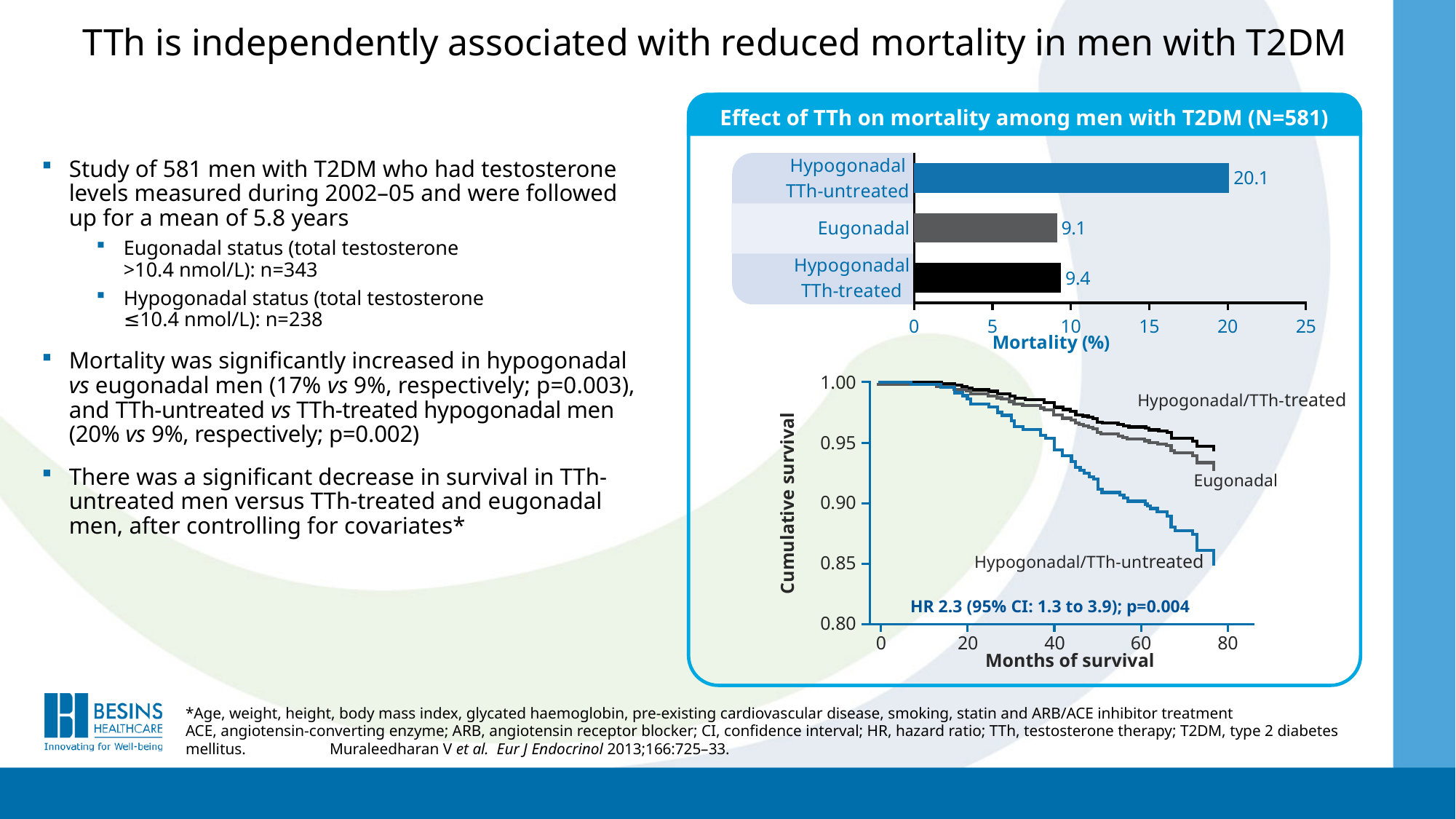
In the bar chart 'Effect of TTh on mortality among men with T2DM', what is the mortality (%) for the Hypogonadal TTh-untreated group? 20.1 In the bar chart 'Effect of TTh on mortality among men with T2DM', what is the difference in mortality (%) between the Hypogonadal TTh-untreated and Hypogonadal TTh-treated groups? 10.7 In the bar chart 'Effect of TTh on mortality among men with T2DM', which group has the lowest mortality? Eugonadal In the cumulative survival chart (lower chart), what hazard ratio annotation is printed on the chart? HR 2.3 (95% CI: 1.3 to 3.9); p=0.004 In the cumulative survival chart (lower chart), is the cumulative survival of the Hypogonadal/TTh-untreated curve at the end of follow-up greater or less than 0.90? less In the cumulative survival chart (lower chart), do the survival curves rise or fall as months of survival increase? fall In the bar chart 'Effect of TTh on mortality among men with T2DM', what is the mortality (%) for the Eugonadal group? 9.1 In the bar chart 'Effect of TTh on mortality among men with T2DM', what is the mortality (%) for the Hypogonadal TTh-treated group? 9.4 In the bar chart 'Effect of TTh on mortality among men with T2DM', which has higher mortality: Hypogonadal TTh-treated or Eugonadal? Hypogonadal TTh-treated What kind of chart is the upper chart in the 'Effect of TTh on mortality among men with T2DM' panel? Bar chart How many bars are shown in the bar chart 'Effect of TTh on mortality among men with T2DM'? 3 In the bar chart 'Effect of TTh on mortality among men with T2DM', which group has the highest mortality? Hypogonadal TTh-untreated